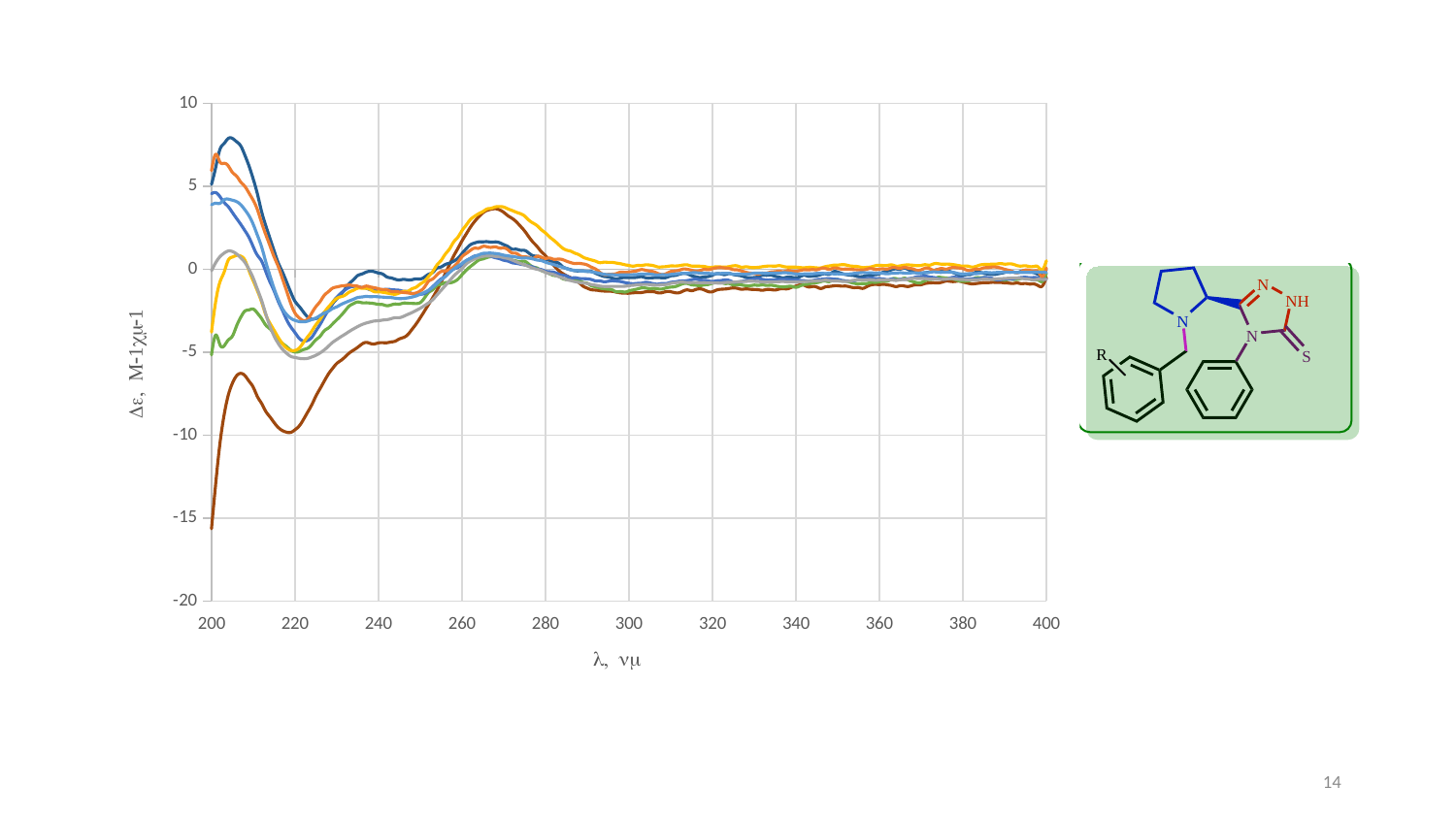
Between 205 nm and 220 nm, does the dark blue line rise or fall? fall Is the peak value of the dark blue line near 205 nm greater or less than 5? greater What kind of chart is shown on the slide? line chart Is the minimum value of the brown line near 200 nm greater or less than -10? less Between 220 nm and 270 nm, does the brown line rise or fall? rise What range of wavelengths does the horizontal axis of the chart cover? 200 to 400 Which line reaches the lowest value on the chart, near 200 nm? the brown line Is the value of the brown line at 220 nm greater or less than -5? less Which line reaches the highest peak on the chart, near 205 nm? the dark blue line At 220 nm, which line has the larger value, the dark blue line or the brown line? the dark blue line What is the lowest value shown on the vertical axis of the chart? -20